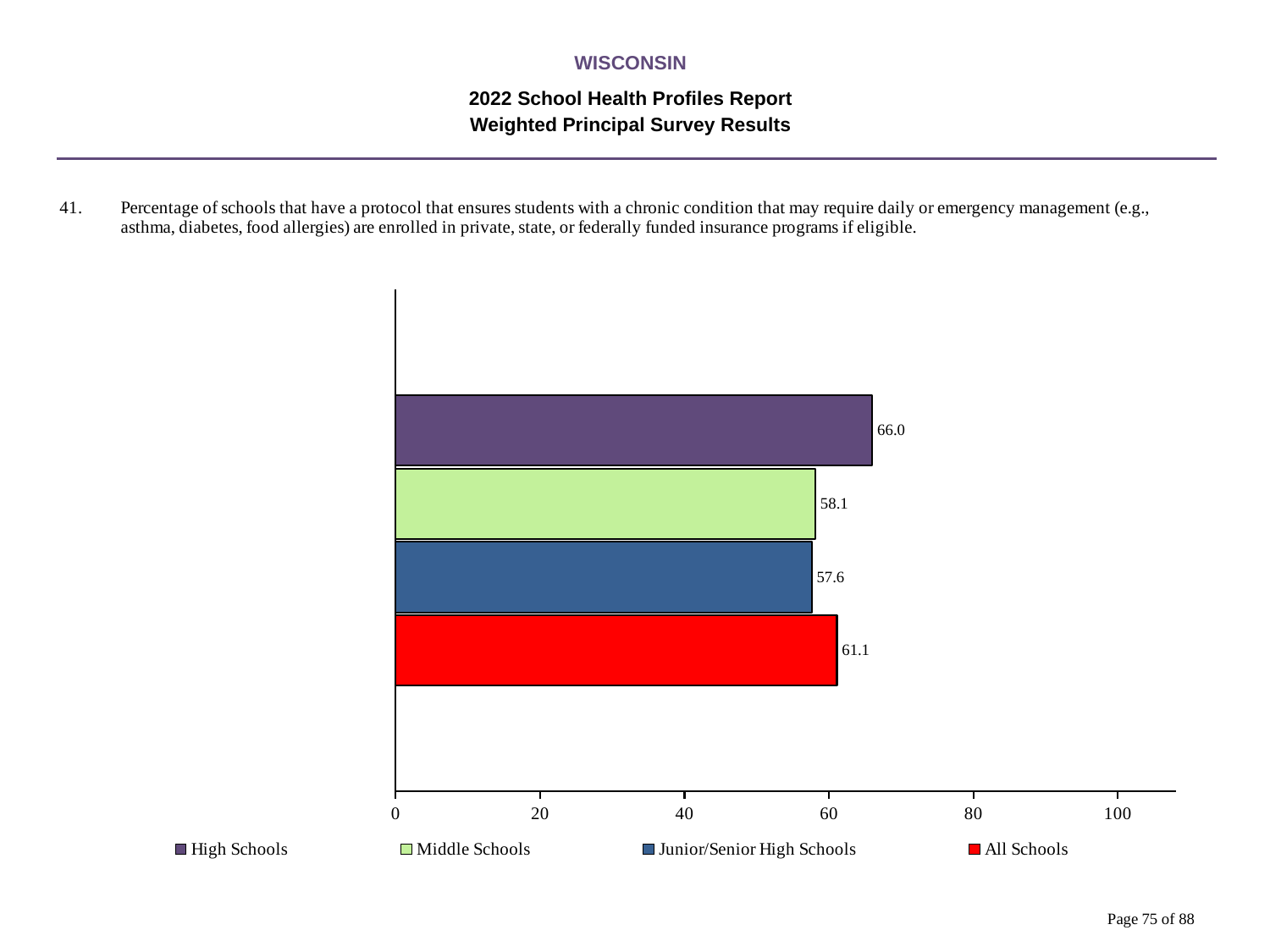
What kind of chart is shown on the slide? bar chart Is the value for High Schools greater or less than 60? greater What colour is the bar for All Schools? red How many series does the legend list? 4 What is the difference between the High Schools value and the All Schools value? 4.9 What is the value for Junior/Senior High Schools? 57.6 What is the value for Middle Schools? 58.1 What is the value for All Schools? 61.1 What is the difference between the Middle Schools value and the Junior/Senior High Schools value? 0.5 What is the value for High Schools? 66.0 Which is larger, the value for High Schools or the value for All Schools? High Schools Which series has the highest value? High Schools